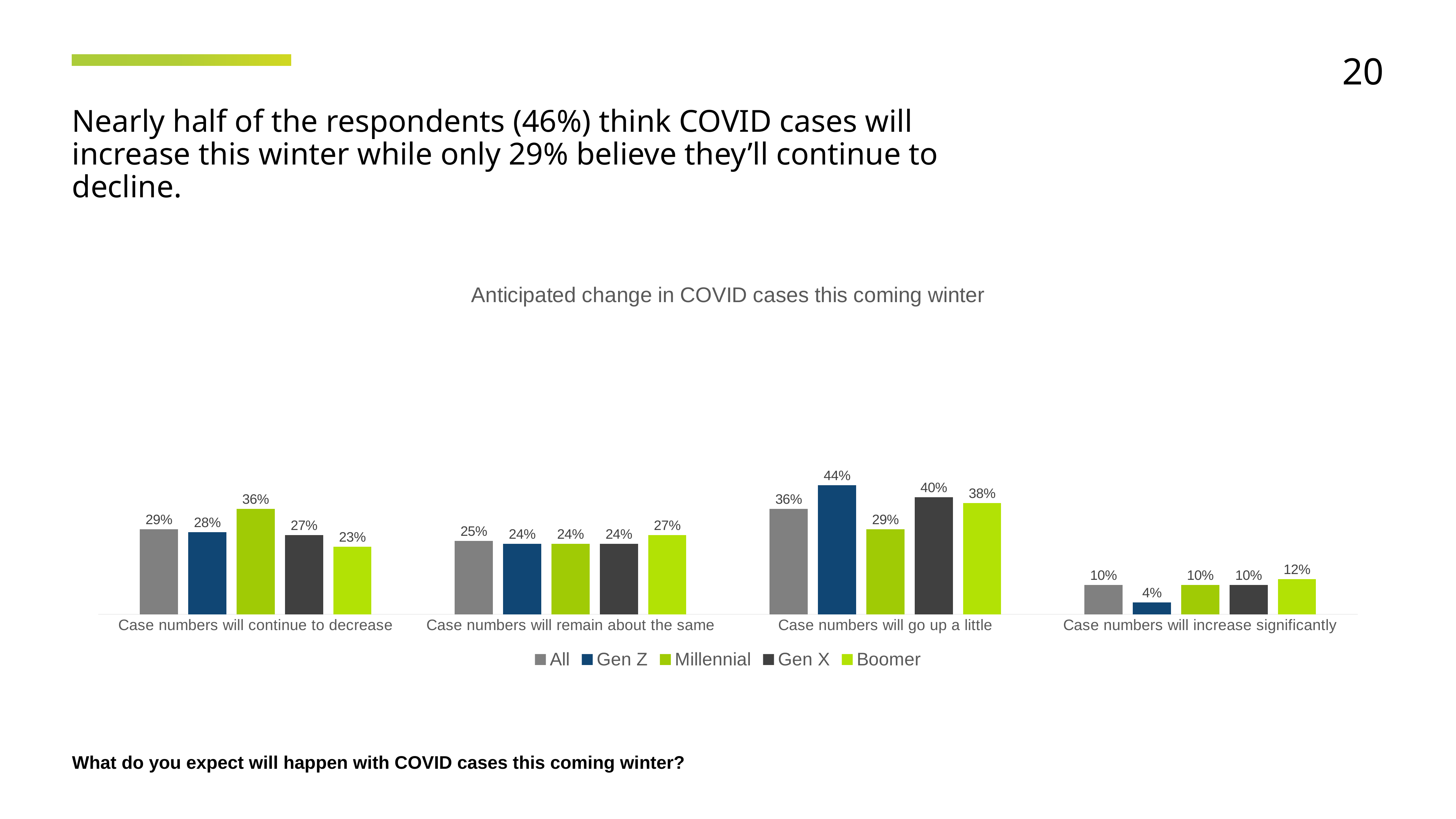
How many series does the legend list? 5 What kind of chart is shown on the slide? Bar chart What is the value for Gen Z in the 'Case numbers will go up a little' category? 44% What is the value for Gen Z in the 'Case numbers will increase significantly' category? 4% Which series has the highest value in the 'Case numbers will go up a little' category? Gen Z What is the difference between the Gen Z and Millennial values in the 'Case numbers will go up a little' category? 15% What is the value for Boomer in the 'Case numbers will remain about the same' category? 27% What is the value for Millennial in the 'Case numbers will continue to decrease' category? 36% How many categories are shown on the x axis? 4 What is the title of the chart? Anticipated change in COVID cases this coming winter Which series has the lowest value in the 'Case numbers will continue to decrease' category? Boomer Which is larger: the Gen X value for 'Case numbers will go up a little' or the Boomer value for the same category? Gen X